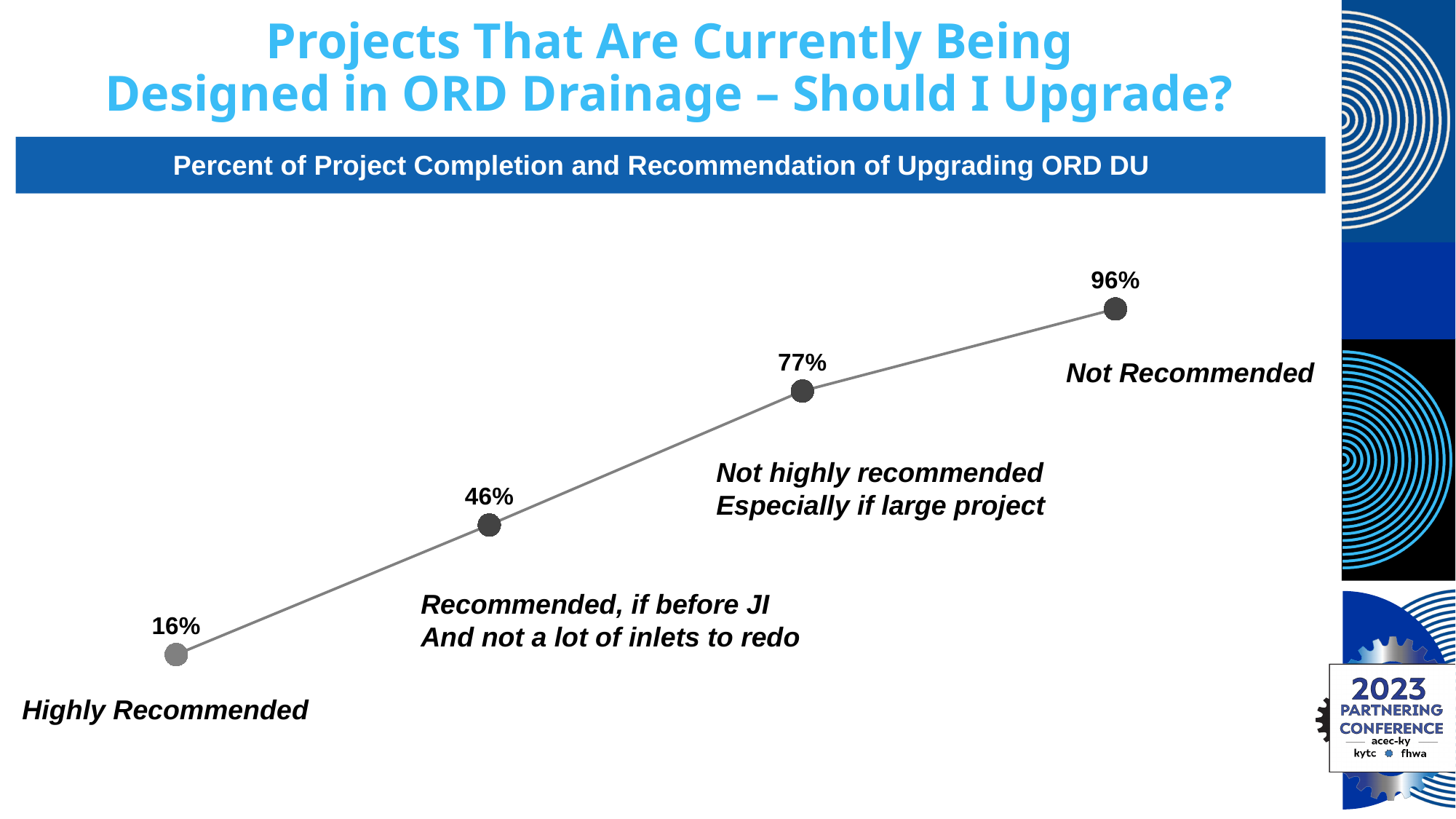
Which point on the chart has the lowest percent value? Highly Recommended (16%) Which point on the chart has the highest percent value? Not Recommended (96%) What is the title shown in the blue banner above the chart? Percent of Project Completion and Recommendation of Upgrading ORD DU What is the percent of project completion at the point labelled "Highly Recommended"? 16% What is the percent of project completion at the point labelled "Not Recommended"? 96% What kind of chart is shown on the slide? line chart What is the difference between the 77% point and the 46% point? 31% What is the percent of project completion at the point labelled "Not highly recommended"? 77% Do the plotted values rise or fall from left to right along the chart? rise How many data points are plotted on the line chart? 4 What is the difference between the highest and lowest percent values on the chart? 80% What is the percent of project completion at the point labelled "Recommended, if before JI"? 46%